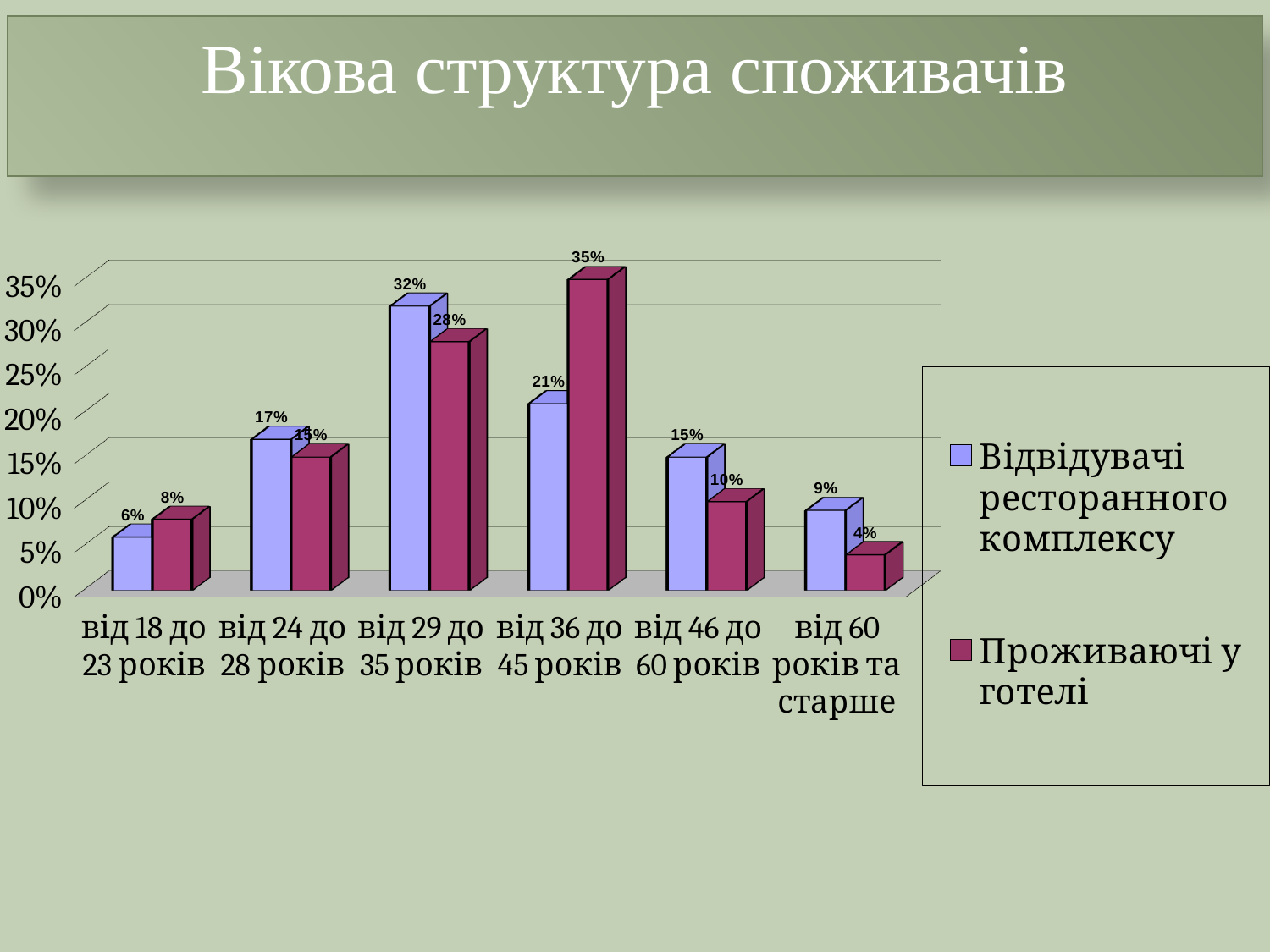
In the 'від 46 до 60 років' category, which series has the larger value? Відвідувачі ресторанного комплексу What is the value for 'Проживаючі у готелі' in the 'від 60 років та старше' category? 4% Which age category has the highest value for 'Проживаючі у готелі'? від 36 до 45 років How many series does the legend list? 2 What is the value for 'Відвідувачі ресторанного комплексу' in the 'від 29 до 35 років' category? 32% What is the title of the chart? Вікова структура споживачів Which age category has the lowest value for 'Відвідувачі ресторанного комплексу'? від 18 до 23 років What is the value for 'Проживаючі у готелі' in the 'від 36 до 45 років' category? 35% Which colour represents the 'Проживаючі у готелі' series? Magenta (dark pink) What type of chart is shown on the slide? Bar chart How many age categories are shown on the x axis? 6 What is the difference between the two series in the 'від 36 до 45 років' category? 14%